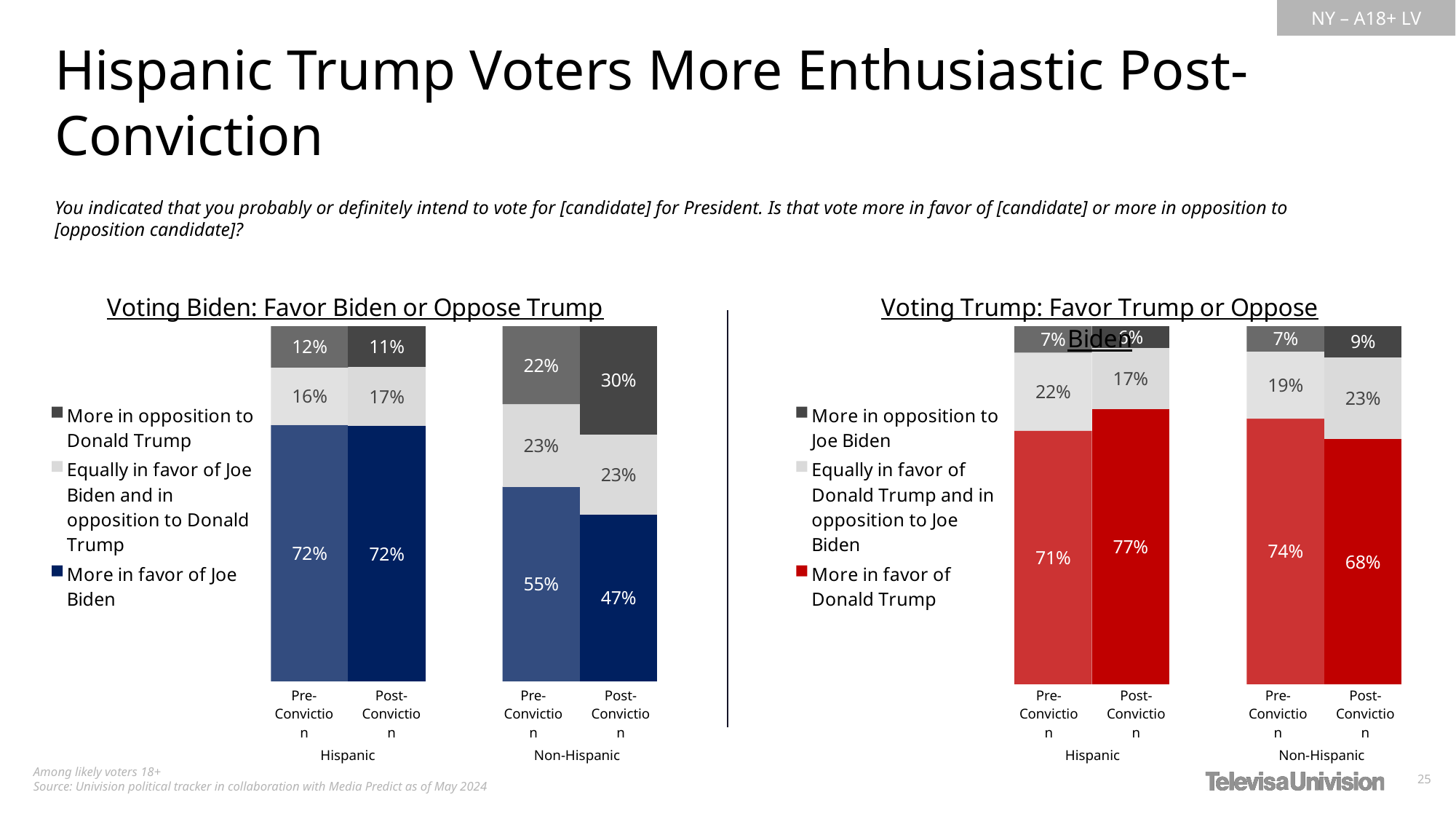
In the 'Voting Trump: Favor Trump or Oppose Biden' chart, what share of Hispanic Post-Conviction voters are 'More in favor of Donald Trump'? 77% What type of chart is the 'Voting Biden: Favor Biden or Oppose Trump' chart? Stacked bar chart In the 'Voting Biden: Favor Biden or Oppose Trump' chart, what share of Non-Hispanic Post-Conviction voters are 'More in opposition to Donald Trump'? 30% In the 'Voting Trump: Favor Trump or Oppose Biden' chart, what is the difference between the 'More in favor of Donald Trump' share for Hispanic Pre-Conviction and Hispanic Post-Conviction? 6 percentage points How many bars are shown in the 'Voting Trump: Favor Trump or Oppose Biden' chart? 4 In the 'Voting Biden: Favor Biden or Oppose Trump' chart, what is the difference between the 'More in favor of Joe Biden' share for Non-Hispanic Pre-Conviction and Non-Hispanic Post-Conviction? 8 percentage points In the 'Voting Trump: Favor Trump or Oppose Biden' chart, which bar has the highest 'More in favor of Donald Trump' share? Hispanic Post-Conviction In the 'Voting Biden: Favor Biden or Oppose Trump' chart, what share of Hispanic Pre-Conviction voters are 'More in favor of Joe Biden'? 72% How many series does the legend of the 'Voting Biden: Favor Biden or Oppose Trump' chart list? 3 In the 'Voting Biden: Favor Biden or Oppose Trump' chart, which bar has the lowest 'More in favor of Joe Biden' share? Non-Hispanic Post-Conviction In the 'Voting Trump: Favor Trump or Oppose Biden' chart, what share of Non-Hispanic Post-Conviction voters are 'Equally in favor of Donald Trump and in opposition to Joe Biden'? 23% In the 'Voting Trump: Favor Trump or Oppose Biden' chart, is the 'More in favor of Donald Trump' share larger for Non-Hispanic Pre-Conviction or Non-Hispanic Post-Conviction? Non-Hispanic Pre-Conviction